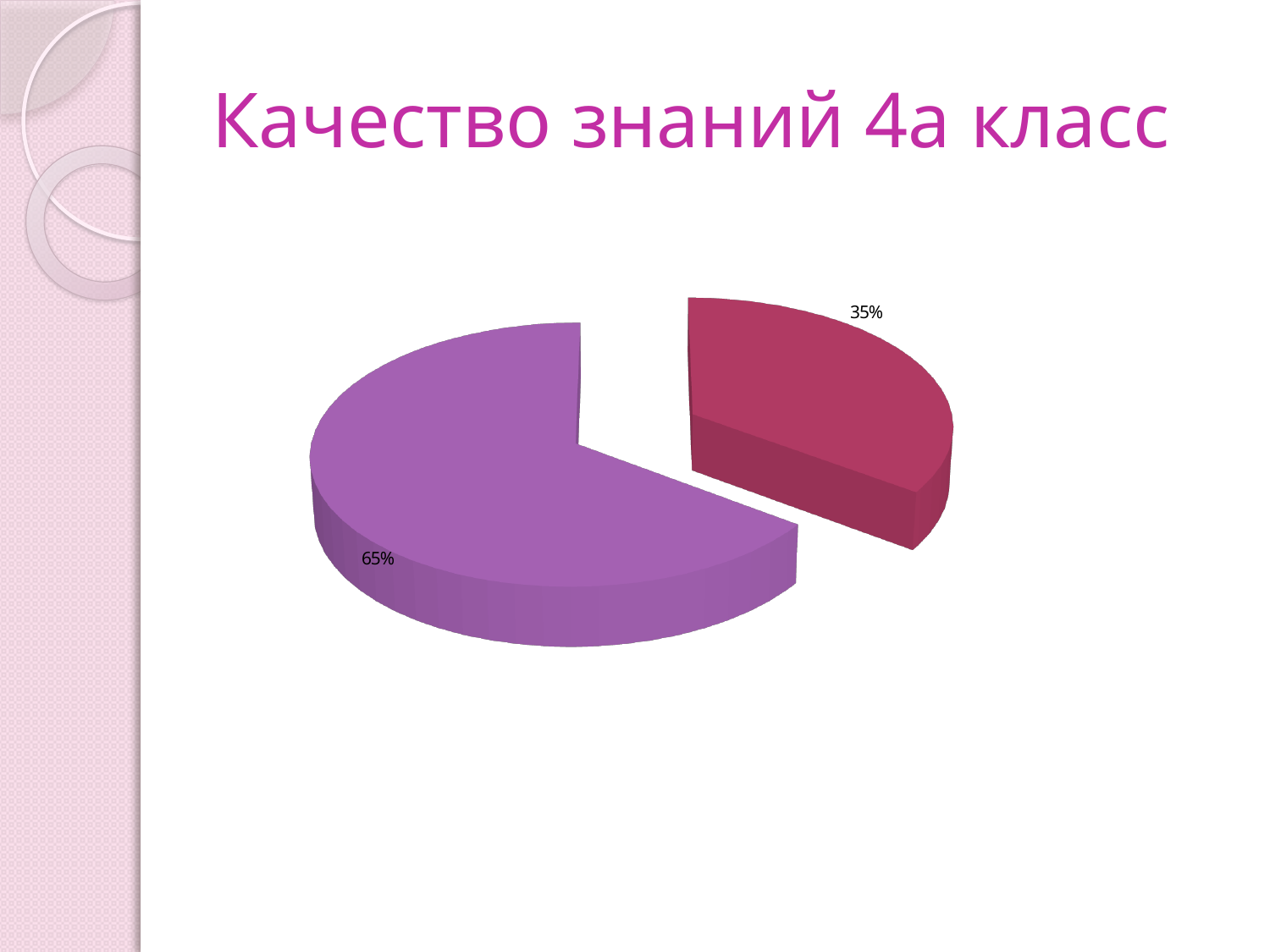
What percentage is shown for the red slice of the pie chart? 35% How many slices does the pie chart have? 2 What share of the pie does the red slice represent? 35% Which slice of the pie chart is the largest? the purple slice (65%) What kind of chart is shown on the slide? pie chart What percentage is shown for the purple slice of the pie chart? 65% Which slice of the pie chart is the smallest? the red slice (35%) What is the title of the slide containing the pie chart? Качество знаний 4а класс Which slice of the pie chart is pulled out (exploded) from the rest? the red slice (35%) Which is larger, the purple slice or the red slice? the purple slice What is the difference in percentage points between the purple slice and the red slice? 30